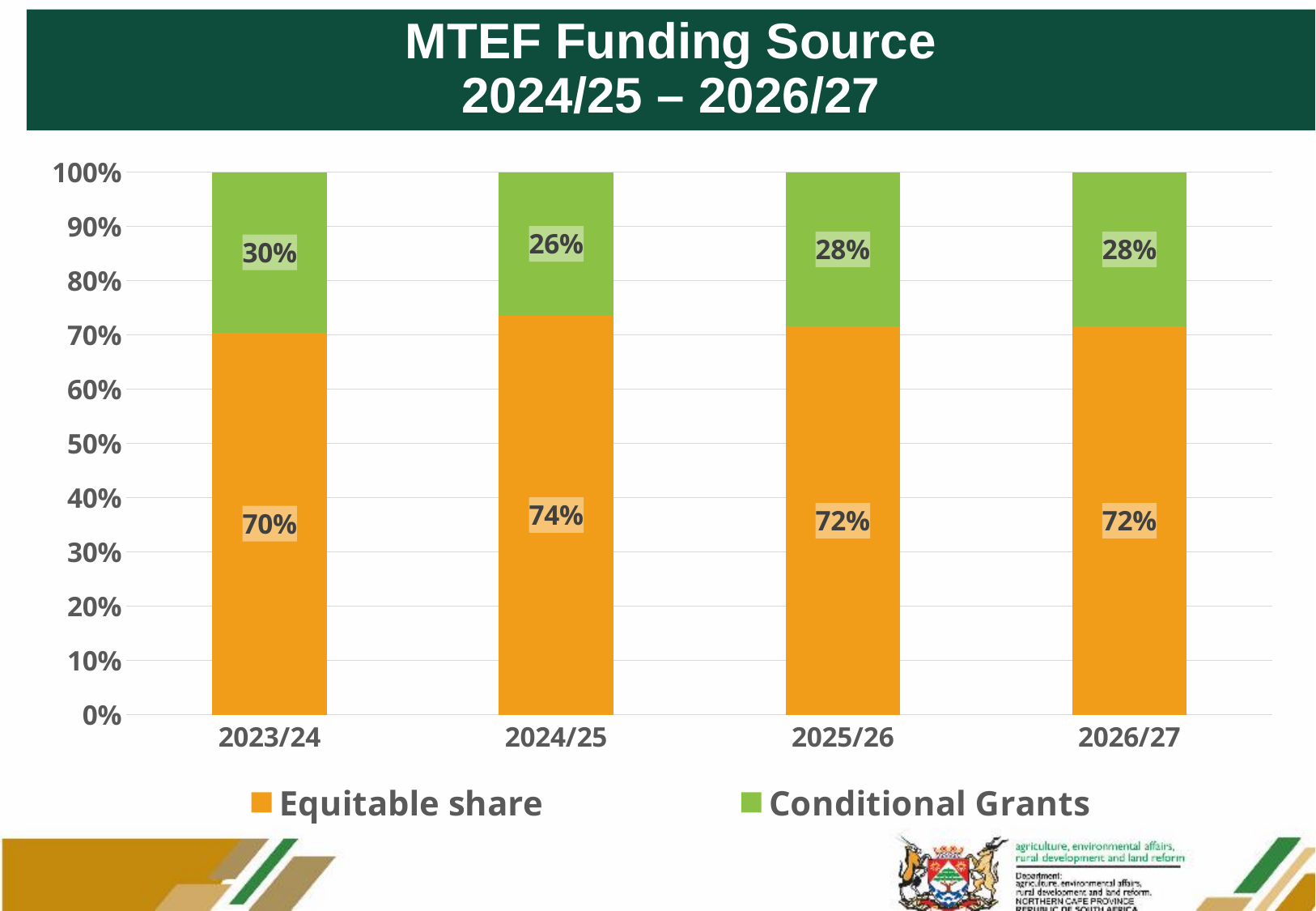
Which year has the highest Equitable share? 2024/25 Which year has the lowest Conditional Grants share? 2024/25 What is the total of the stacked bar for 2025/26? 100% Is the Conditional Grants value larger in 2023/24 or in 2025/26? 2023/24 How many years are shown on the x axis? 4 What is the Conditional Grants value for 2023/24? 30% What is the difference between the Equitable share and Conditional Grants values in 2023/24? 40% Which colour represents Conditional Grants in the legend? Green How many series does the legend list? 2 What is the Equitable share value for 2026/27? 72% What kind of chart is shown? Stacked bar chart What is the Equitable share value for 2024/25? 74%